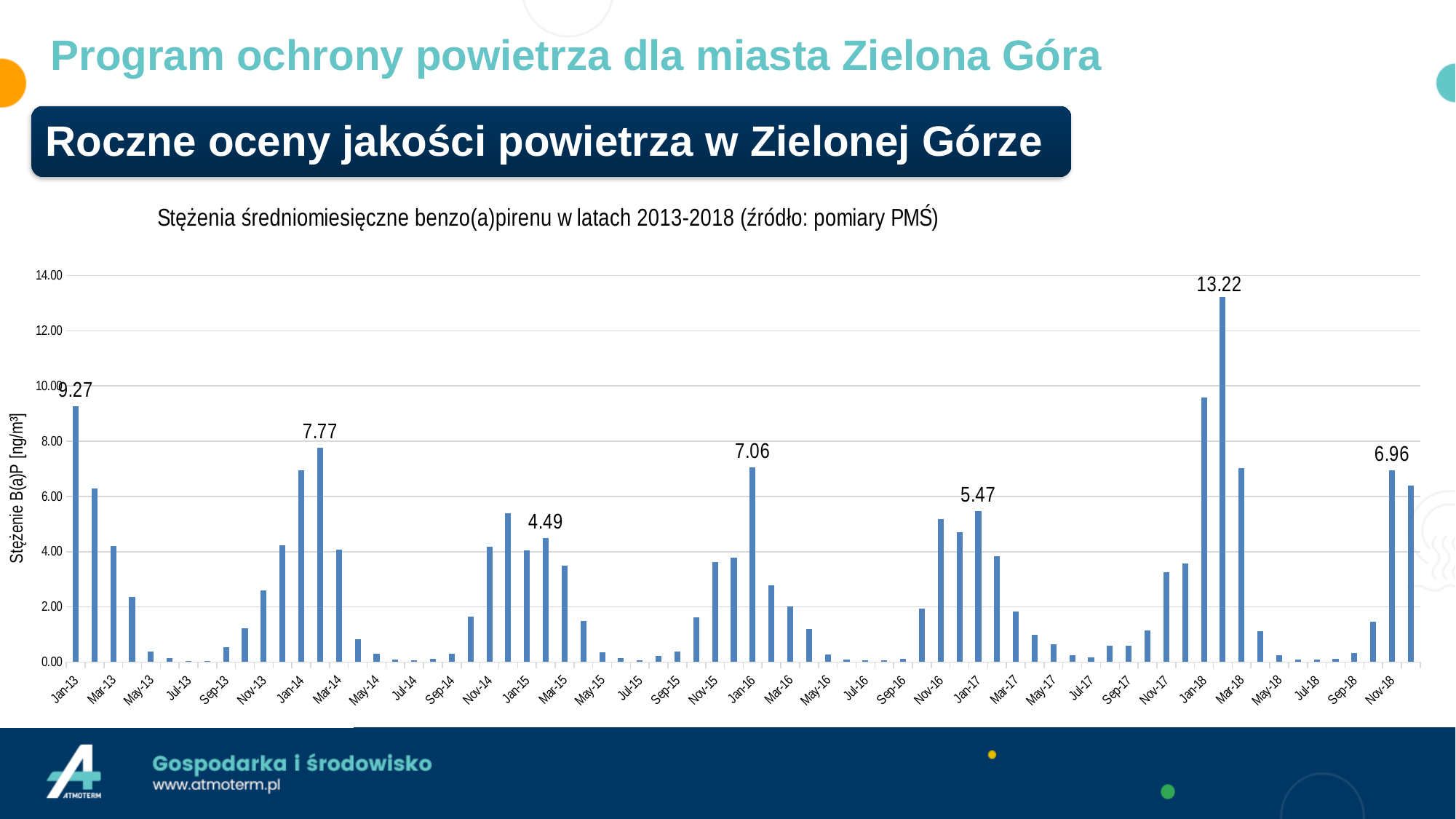
What is the difference between the values for Jan-16 and Jan-17? 1.59 Is the value for Jan-18 greater or less than 8.00? greater Which is larger, the value for Jan-13 or the value for Jan-16? Jan-13 What is the value for Jan-16? 7.06 What is the value for Jan-13? 9.27 What is the value for Nov-18? 6.96 What kind of chart is shown on the slide? bar chart What is the value for Jan-17? 5.47 Is the value for Jul-13 greater or less than 2.00? less What is the label of the vertical axis? Stężenie B(a)P [ng/m³] What is the difference between the tallest bar (13.22) and the value for Jan-13? 3.95 What is the value of the tallest bar on the chart? 13.22